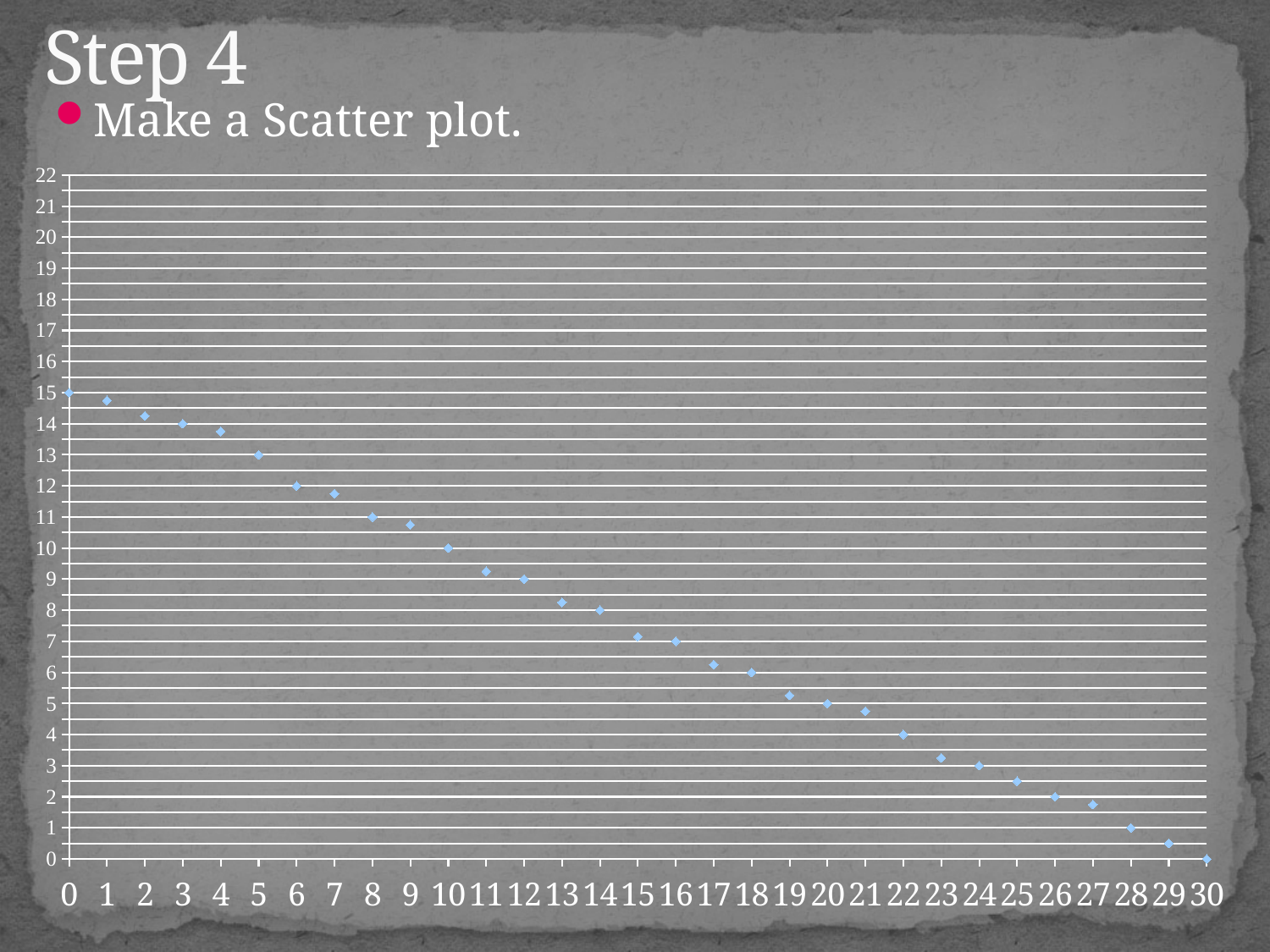
Do the plotted values rise or fall as x increases from 0 to 30? fall At which x value is the plotted y value lowest? 30 Which point has the larger y value, the one at x = 2 or the one at x = 20? x = 2 What is the y value of the point at x = 30? 0 What is the y value of the point at x = 10? 10 Is the y value for x = 25 greater or less than 5? less How many points are plotted on the scatter plot? 31 Is the y value for x = 5 greater or less than 12? greater What is the highest value shown on the y axis? 22 At which x value is the plotted y value highest? 0 What is the y value of the point at x = 0? 15 What kind of chart is shown on the slide? scatter plot